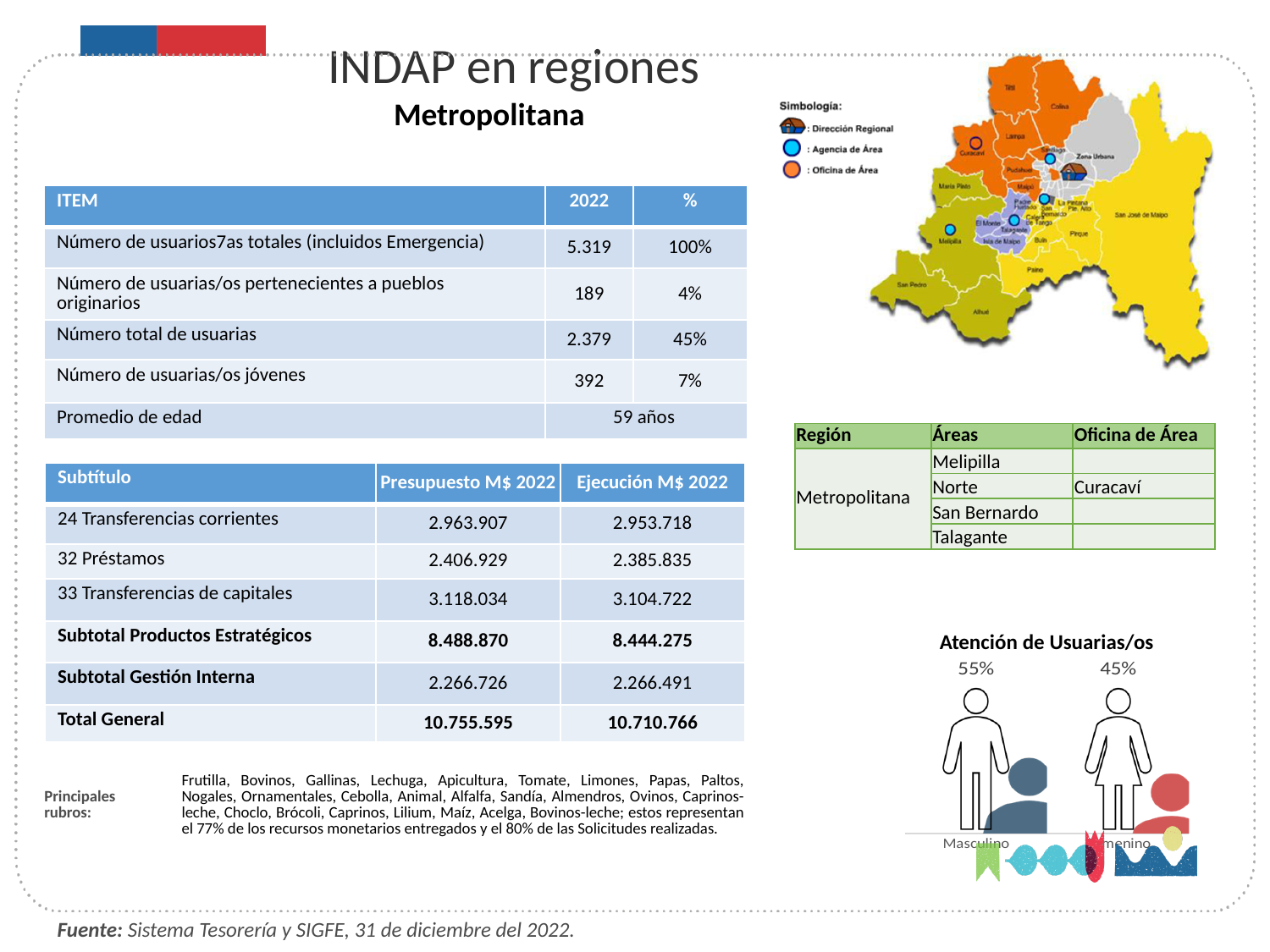
In the 'Atención de Usuarias/os' chart, is the value for Femenino greater or less than 50%? less In the 'Atención de Usuarias/os' chart, what do the Masculino and Femenino percentages add up to? 100% In the 'Atención de Usuarias/os' chart, which category has the higher percentage? Masculino What is the title of the chart in the lower right of the slide? Atención de Usuarias/os In the 'Atención de Usuarias/os' chart, is the value for Masculino larger or smaller than the value for Femenino? larger How many categories are shown in the 'Atención de Usuarias/os' chart? 2 In the 'Atención de Usuarias/os' chart, what is the difference between the Masculino and Femenino percentages? 10% In the 'Atención de Usuarias/os' chart, what percentage is shown for Masculino? 55% What kind of chart is 'Atención de Usuarias/os'? pictogram chart In the 'Atención de Usuarias/os' chart, what percentage is shown for Femenino? 45% In the 'Atención de Usuarias/os' chart, which category has the lower percentage? Femenino